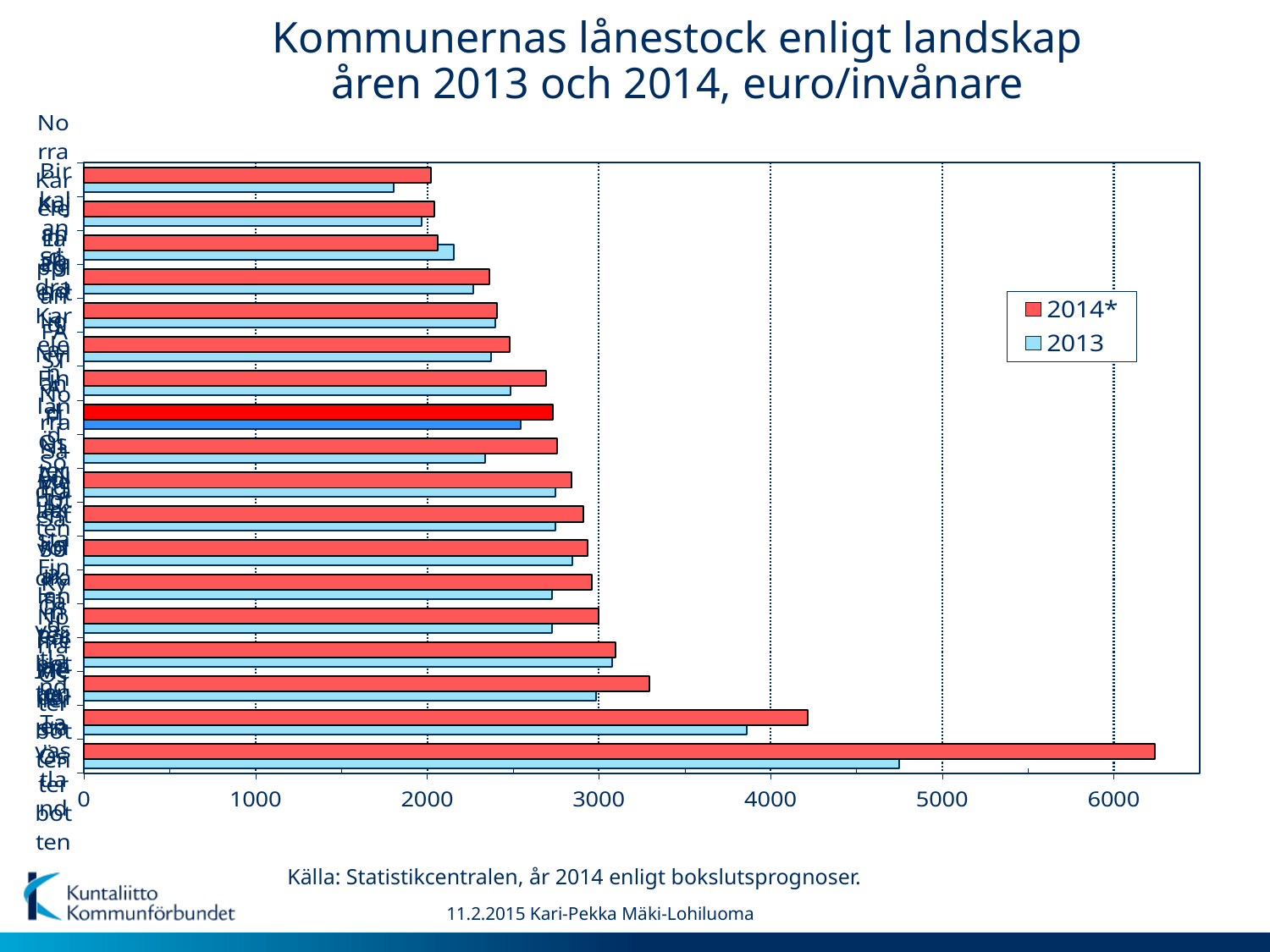
How many series does the legend list? 2 How many categories (pairs of bars) are plotted in the chart? 18 What kind of chart is shown on the slide? bar chart Do the 2014* bars generally get longer or shorter going from the top of the chart to the bottom? longer Is the longest 2014* bar (the bottom category) greater or less than 6000? greater For the bottom category, which series has the larger value, 2014* or 2013? 2014* Is the 2014* value for the second-longest category (second from the bottom) greater or less than 4000? greater What is the title of the chart? Kommunernas lånestock enligt landskap åren 2013 och 2014, euro/invånare What are the two series named in the legend? 2014* and 2013 Is the 2013 value for the top category greater or less than 2000? less What is the highest value shown on the horizontal axis? 6000